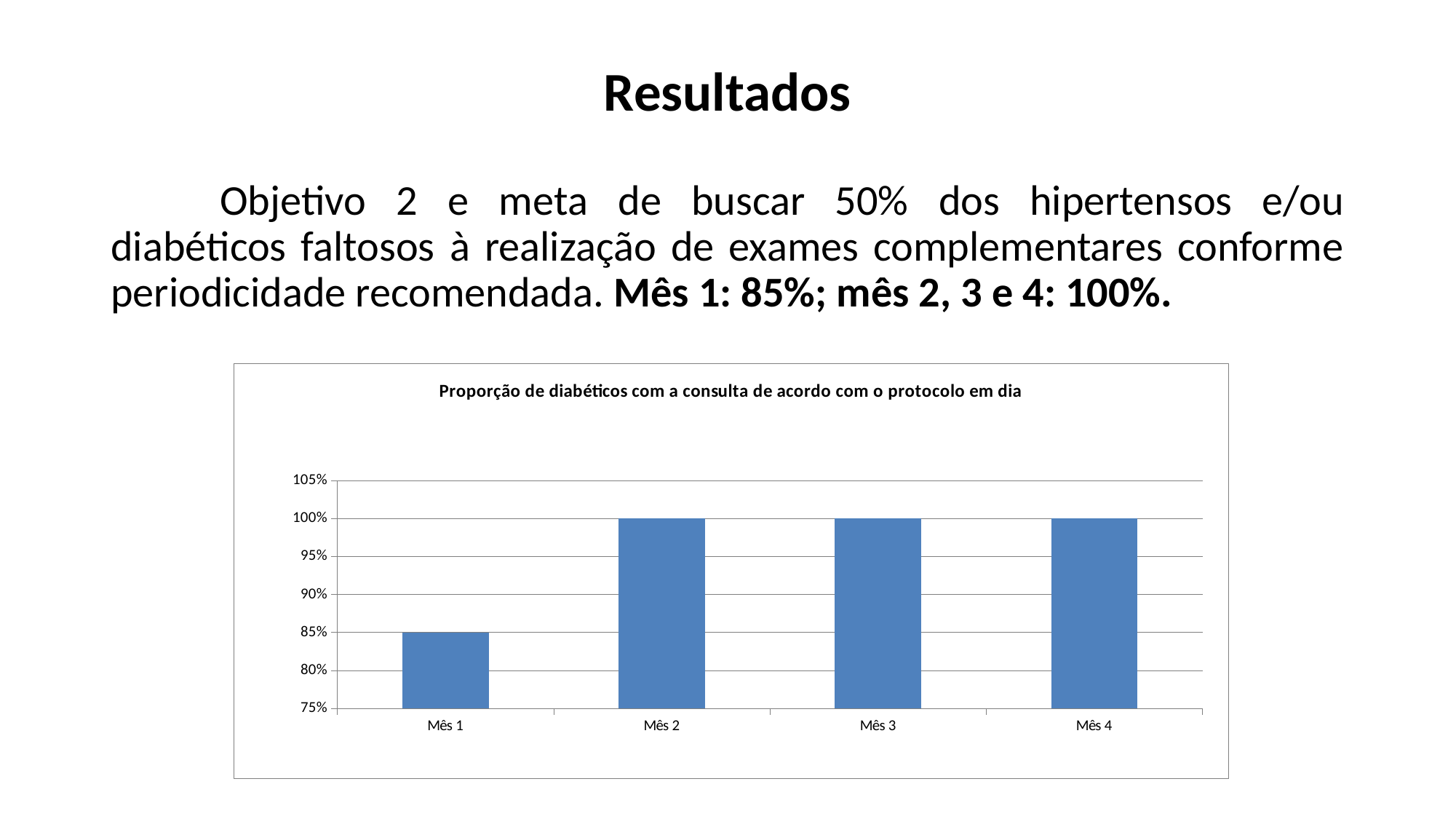
Is the value for Mês 3 greater or less than 95%? greater What type of chart is shown on the slide? bar chart How many months are shown on the x axis? 4 What is the title of the chart? Proporção de diabéticos com a consulta de acordo com o protocolo em dia Is the value for Mês 1 greater or less than 90%? less Do the values rise or fall from Mês 1 to Mês 2? rise Which month has the lowest value? Mês 1 What is the difference between the values for Mês 2 and Mês 1? 15% What is the value for Mês 1? 85% Which is larger, the value for Mês 1 or the value for Mês 3? Mês 3 What is the value for Mês 2? 100% What is the value for Mês 4? 100%